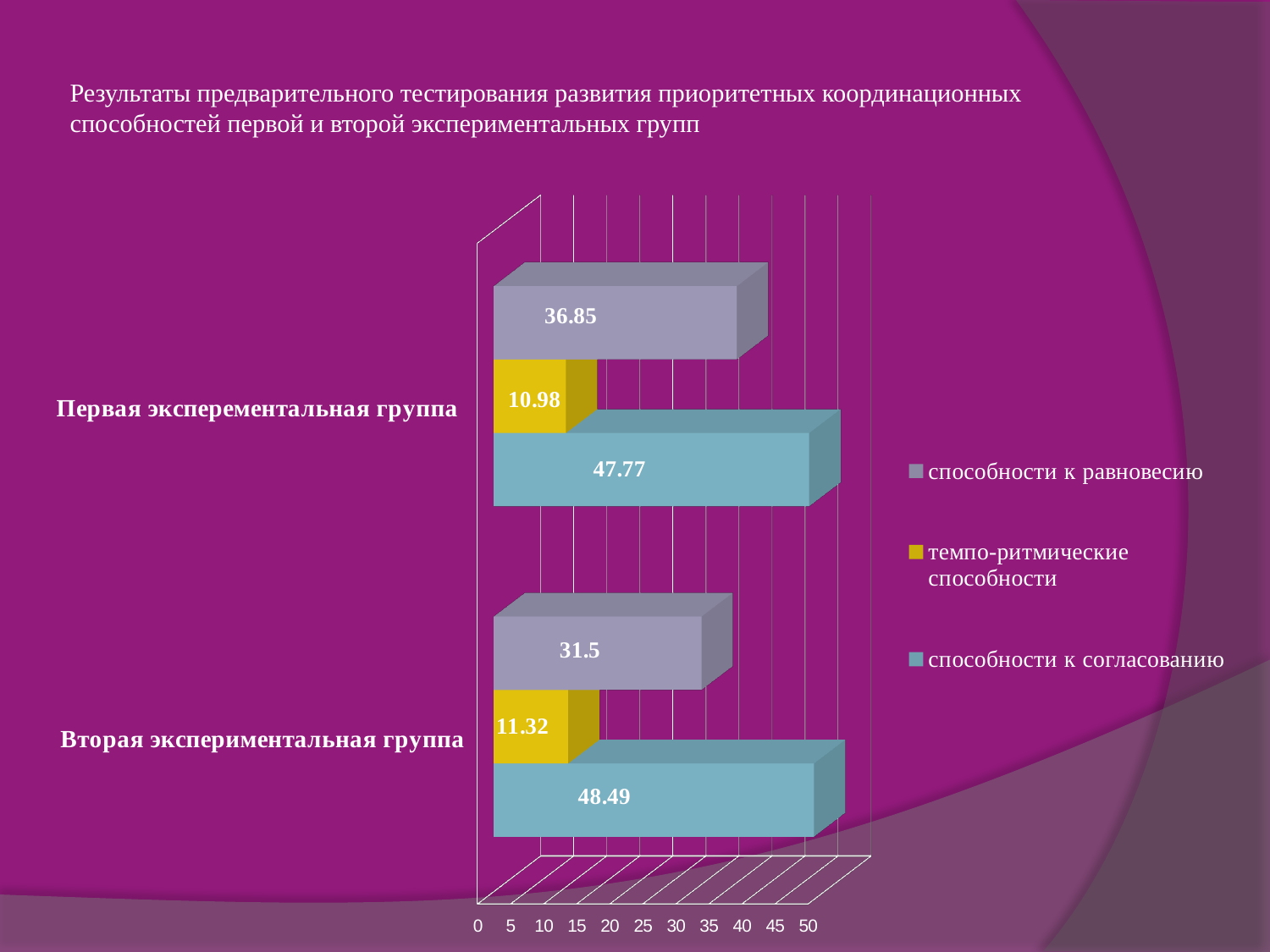
Is the value for способности к согласованию in Вторая экспериментальная группа greater or less than 45? greater What is the value for способности к равновесию in Первая экспериментальная группа? 36.85 What kind of chart is shown on the slide? bar chart What is the value for темпо-ритмические способности in Вторая экспериментальная группа? 11.32 How many groups (categories) are shown on the chart? 2 What is the difference between способности к согласованию in Вторая экспериментальная группа and in Первая экспериментальная группа? 0.72 What is the value for способности к согласованию in Первая экспериментальная группа? 47.77 How many series does the legend list? 3 Which group has the larger value for способности к равновесию? Первая экспериментальная группа Which series has the highest value in Вторая экспериментальная группа? способности к согласованию Which series has the lowest value in Первая экспериментальная группа? темпо-ритмические способности What is the value for способности к равновесию in Вторая экспериментальная группа? 31.5